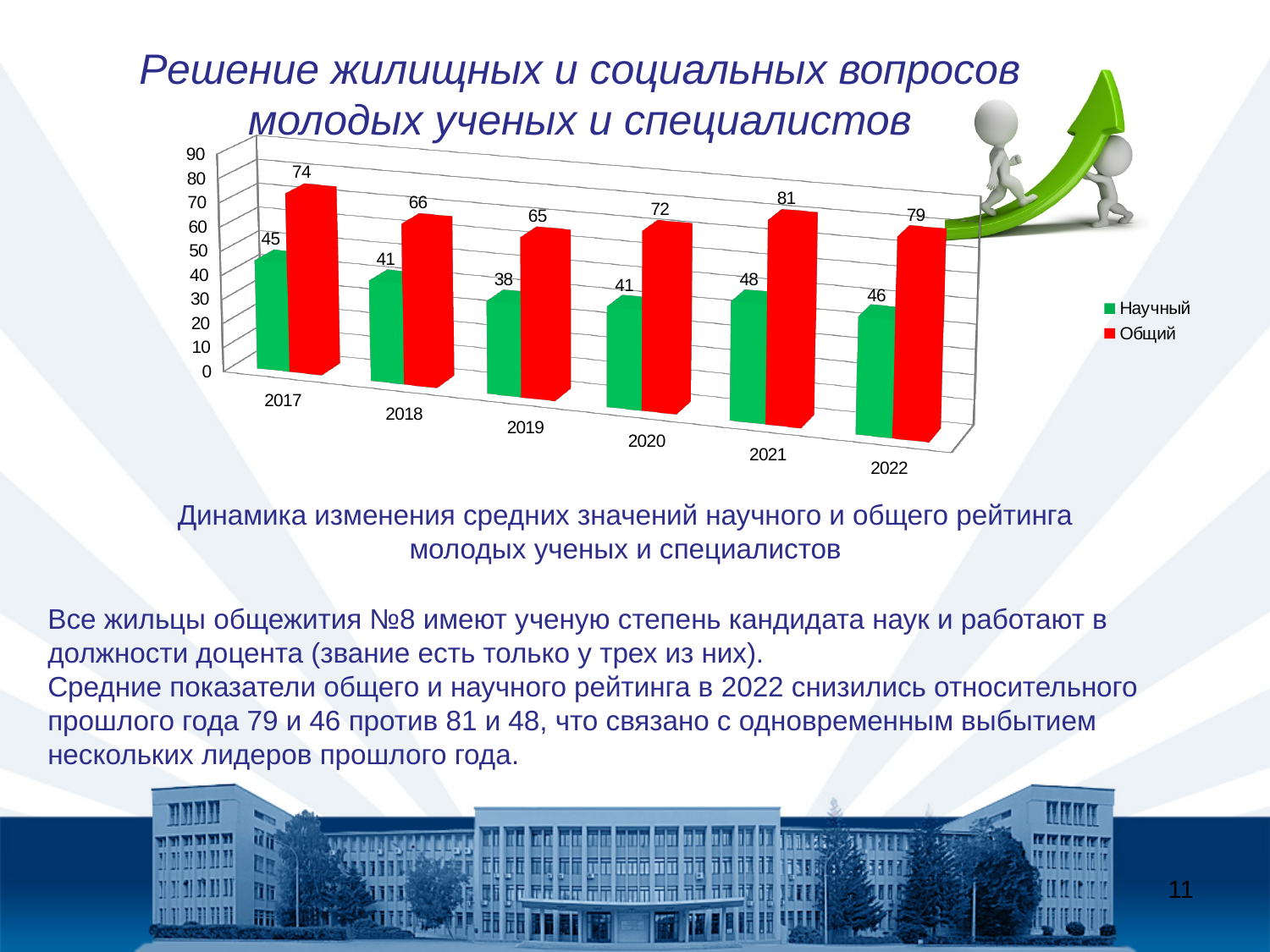
What is the value of Общий for 2021? 81 How many series does the legend list? 2 What kind of chart is shown on the slide? bar chart Which year has the highest Общий value? 2021 Which colour represents the Общий series? red What is the difference between Общий and Научный in 2020? 31 What is the value of Научный for 2017? 45 Which year has the lowest Научный value? 2019 Which is larger: Научный in 2021 or Научный in 2018? Научный in 2021 How many years are shown on the x axis? 6 Is the value of Общий for 2019 greater or less than 60? greater What is the value of Научный for 2022? 46